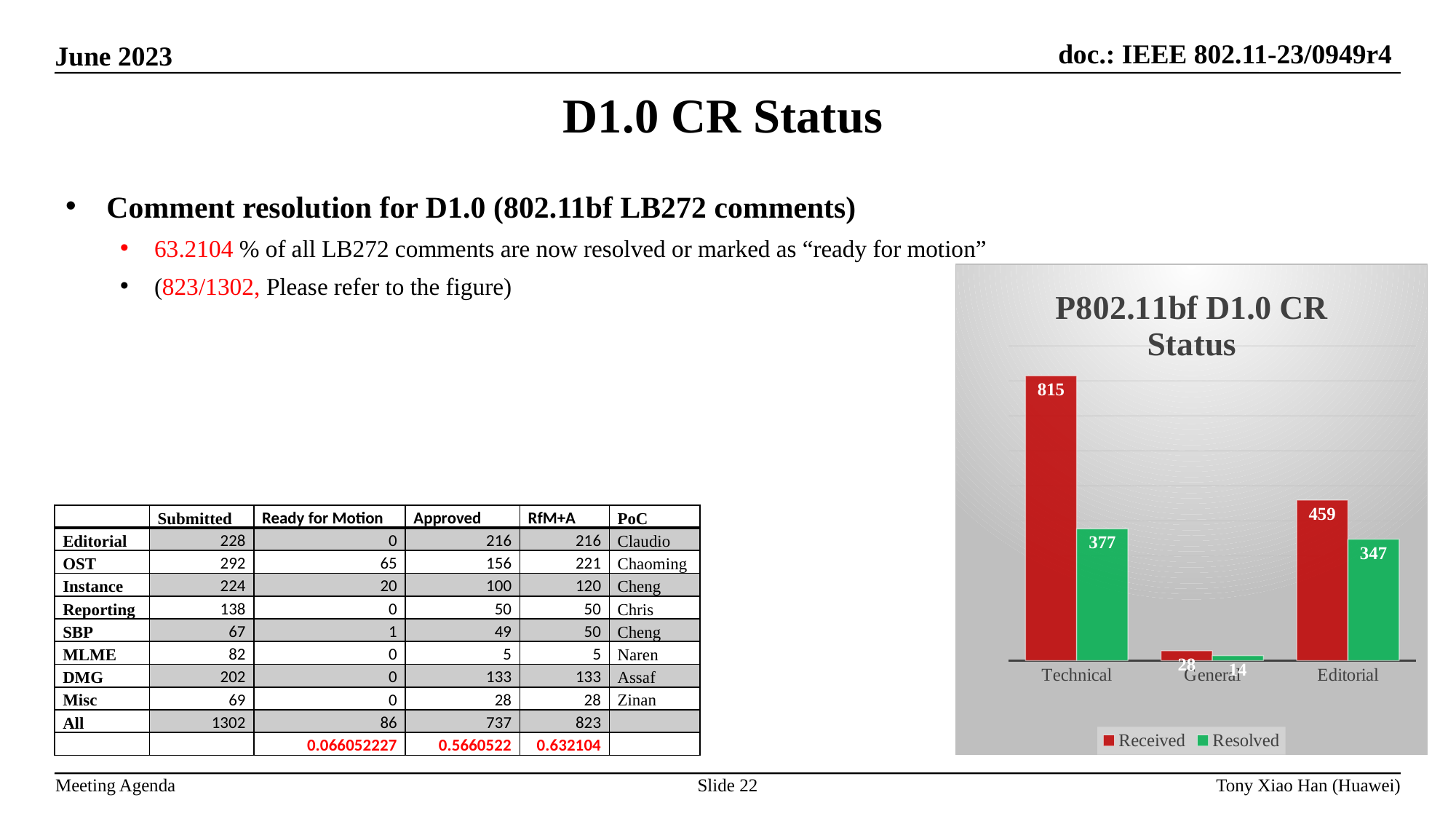
What is the Received value for Technical in the chart? 815 Which is larger in the chart: the Resolved value for Editorial or the Resolved value for Technical? Resolved value for Technical Which colour represents the Resolved series in the chart? green How many series does the chart legend list? 2 What is the difference between the Received and Resolved values for Technical in the chart? 438 What is the Resolved value for Editorial in the chart? 347 Which category has the lowest Resolved value in the chart? General How many categories are shown on the x axis of the chart? 3 Which category has the highest Received value in the chart? Technical What is the title of the chart on the slide? P802.11bf D1.0 CR Status What is the Received value for General in the chart? 28 What kind of chart is shown on the slide? bar chart